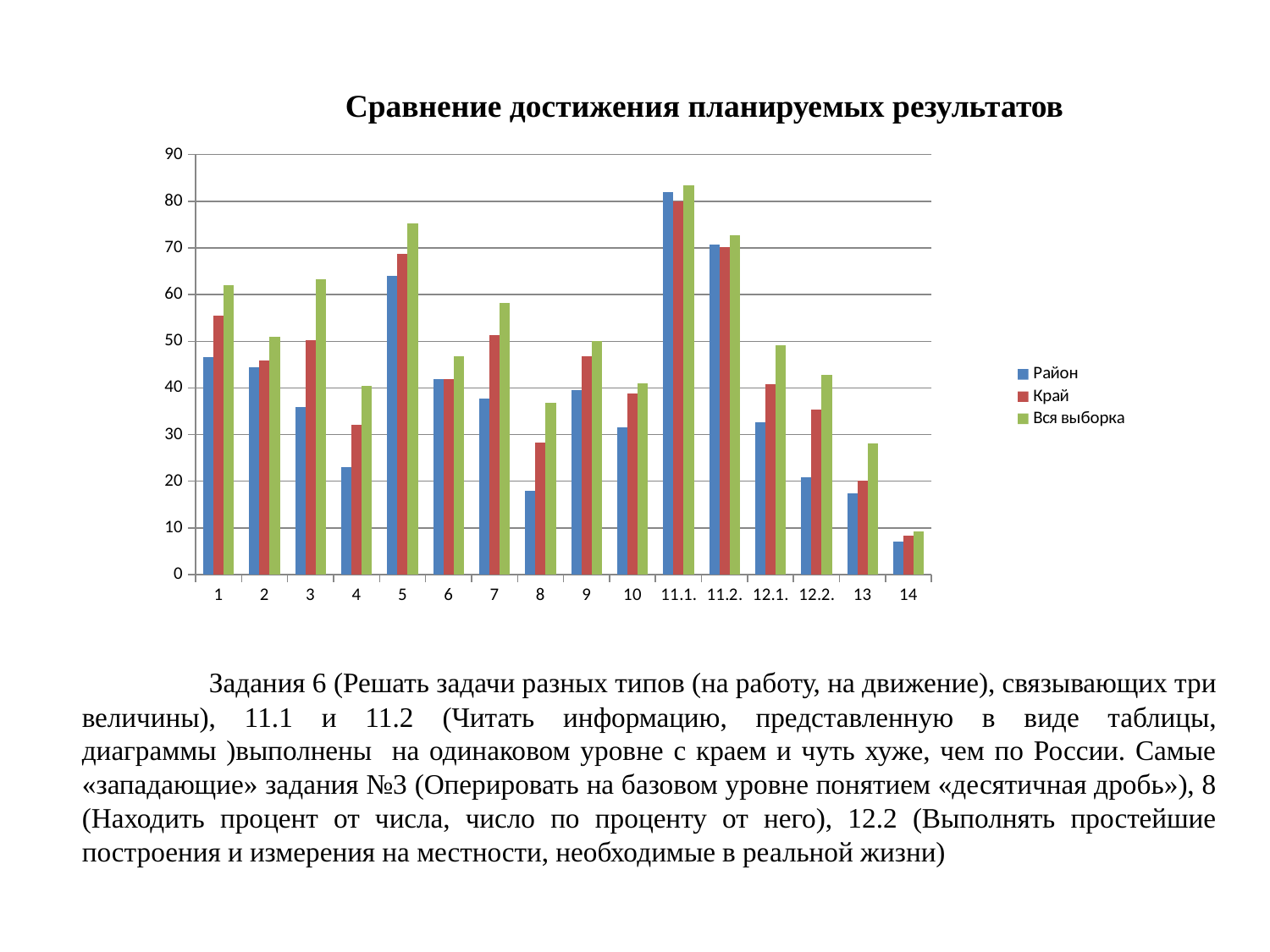
Which category has the lowest value for the Край series? 14 Is the Вся выборка value for category 5 greater or less than 70? greater Is the Район value for category 8 greater or less than 20? less Is the Район value for category 4 greater or less than 30? less What kind of chart is shown on the slide? bar chart For the Район series, which is larger: the value for category 5 or the value for category 6? category 5 For category 3, which series has the larger value: Район or Вся выборка? Вся выборка Which category has the lowest value for the Вся выборка series? 14 Which category has the highest value for the Район series? 11.1. What is the title of the chart? Сравнение достижения планируемых результатов How many series does the legend list? 3 How many categories are shown on the x axis? 16